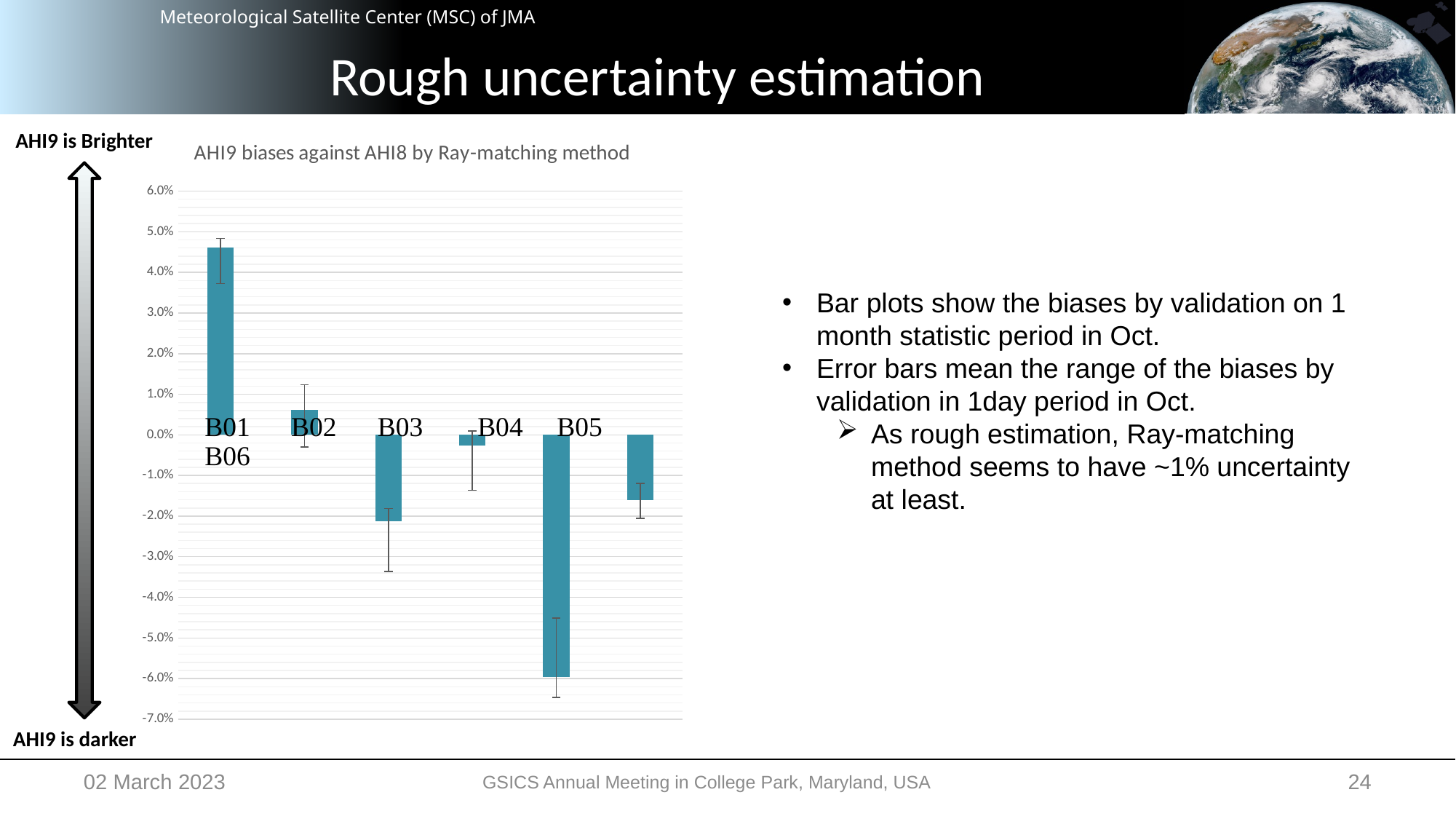
Is the bias value for B01 greater or less than 4.0%? greater Is the bias value for B03 greater or less than -1.0%? less What is the title of the chart? AHI9 biases against AHI8 by Ray-matching method Which band has the lowest (most negative) bias in the chart? B05 How many bands (bars) are plotted in the chart? 6 What is the lowest value shown on the vertical axis of the chart? -7.0% Is the bias value for B06 greater or less than -1.0%? less Which band has the larger bias, B01 or B02? B01 How many bands show a positive bias (bar above 0.0%)? 2 What kind of chart is shown on the slide? bar chart Which band has the highest (most positive) bias in the chart? B01